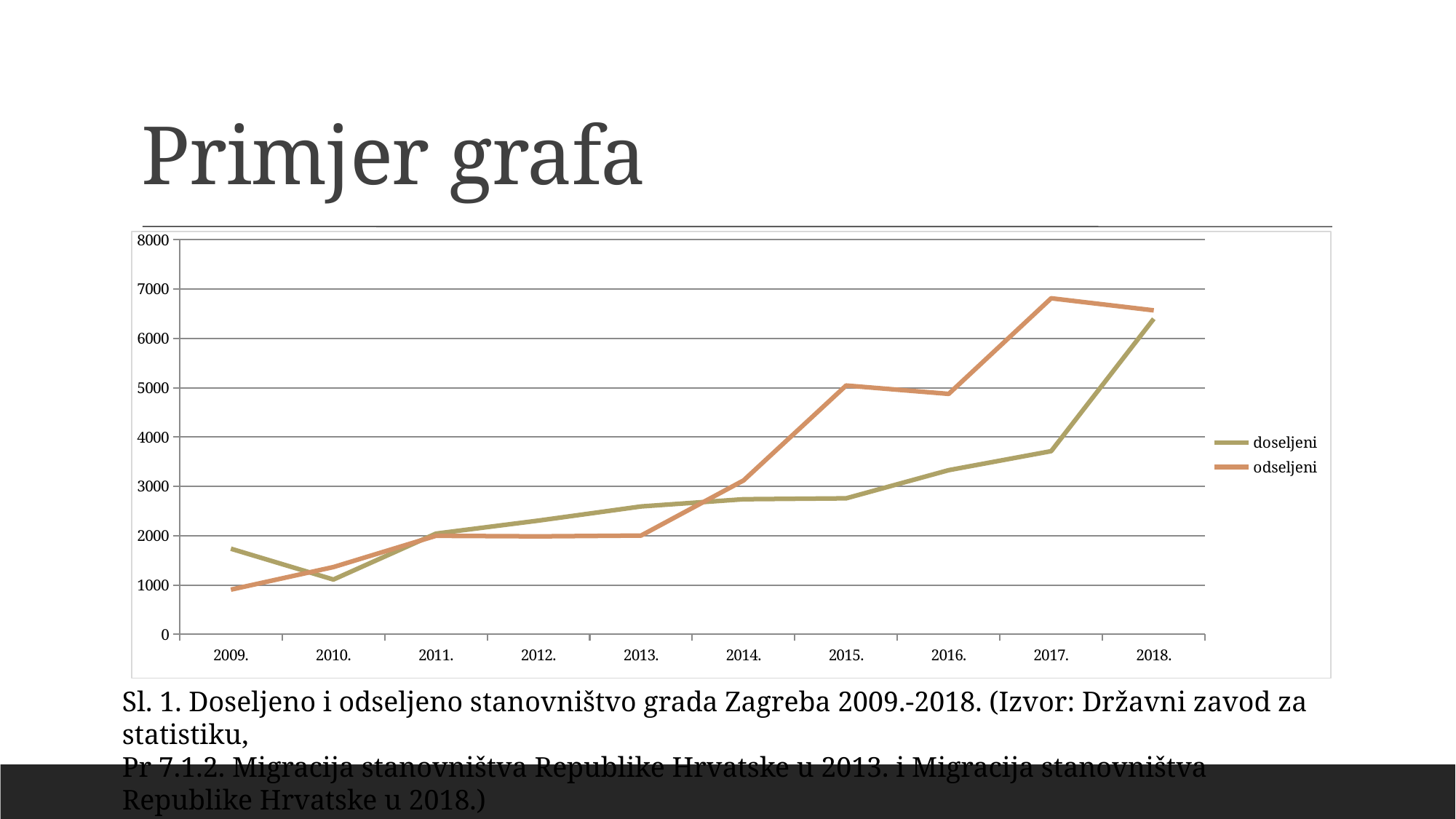
How many years are plotted along the x axis? 10 In which year does the doseljeni series have its lowest value? 2010. In 2009., which series has the larger value, doseljeni or odseljeni? doseljeni Does the doseljeni series rise or fall from 2011. to 2018.? rise Is the value for odseljeni in 2013. greater or less than 3000? less What kind of chart is shown on the slide? line chart What colour is the line for the odseljeni series? orange Is the value for doseljeni in 2018. greater or less than 6000? greater In 2015., which series has the larger value, doseljeni or odseljeni? odseljeni In which year does the odseljeni series reach its highest value? 2017. In which year does the odseljeni series have its lowest value? 2009. How many series does the legend list? 2